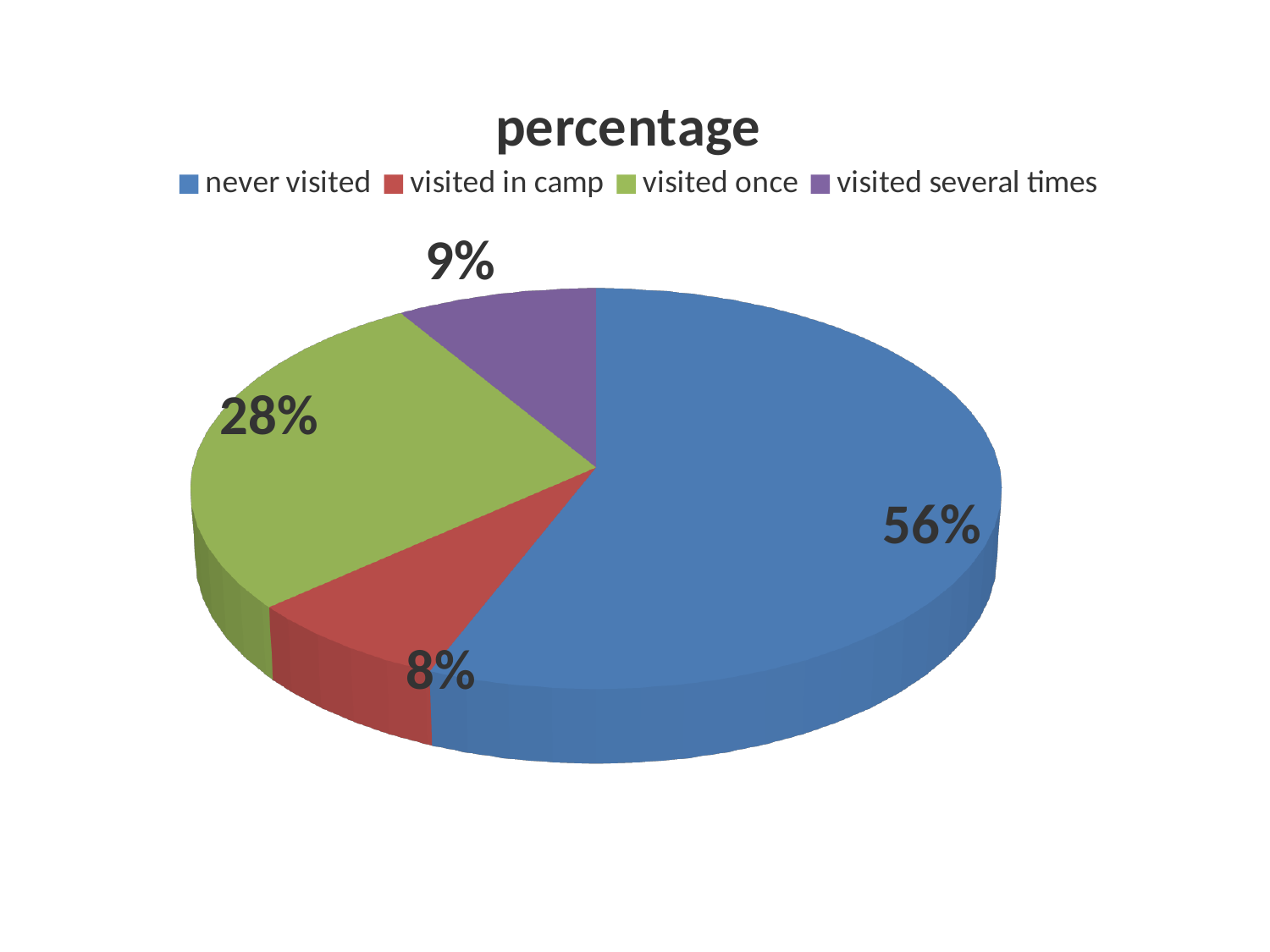
Which category has the largest share of the pie? never visited What is the difference between the shares for 'never visited' and 'visited once'? 28% What is the title of the chart? percentage What percentage is shown for 'visited several times'? 9% What percentage is shown for 'visited once'? 28% Which colour represents 'visited several times' in the legend? purple What percentage is shown for 'never visited'? 56% Which category has the smallest share of the pie? visited in camp Which is larger, the share for 'visited once' or the share for 'visited several times'? visited once What percentage is shown for 'visited in camp'? 8% What type of chart is shown on the slide? pie chart How many categories does the pie chart show? 4